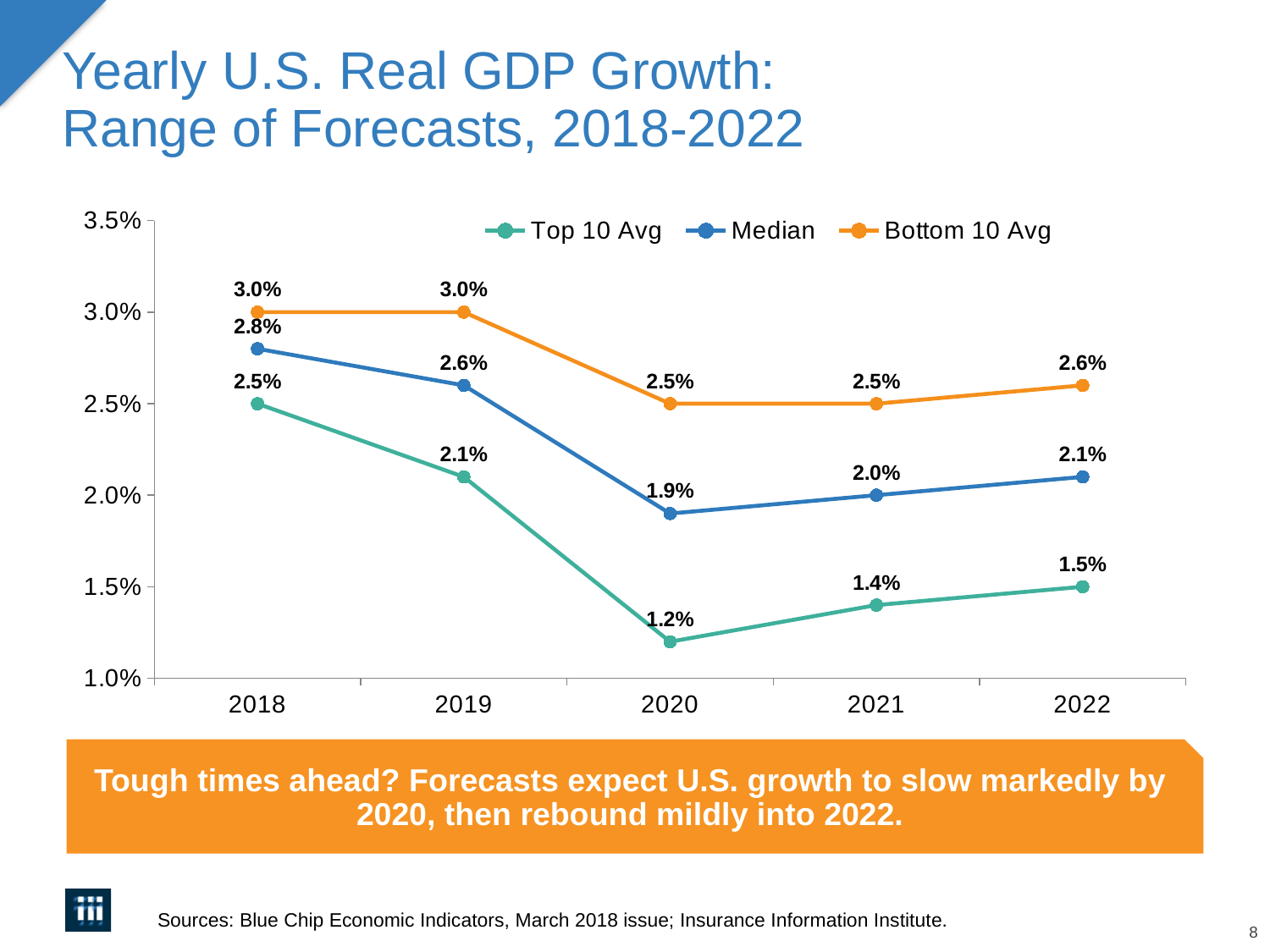
What is the Top 10 Avg forecast value for 2022? 1.5% In which year is the Top 10 Avg forecast lowest? 2020 What is the difference between the Bottom 10 Avg and Top 10 Avg forecasts in 2020? 1.3% In which year is the Median forecast highest? 2018 By how much does the Median forecast fall from 2018 to 2020? 0.9% Which is larger, the Median forecast for 2019 or the Median forecast for 2021? 2019 How many series does the legend list? 3 What kind of chart is shown on the slide? Line chart Does the Top 10 Avg forecast rise or fall from 2018 to 2020? Fall What is the Median forecast for U.S. real GDP growth in 2020? 1.9% How many years are plotted on the x axis? 5 What is the Bottom 10 Avg forecast value for 2019? 3.0%